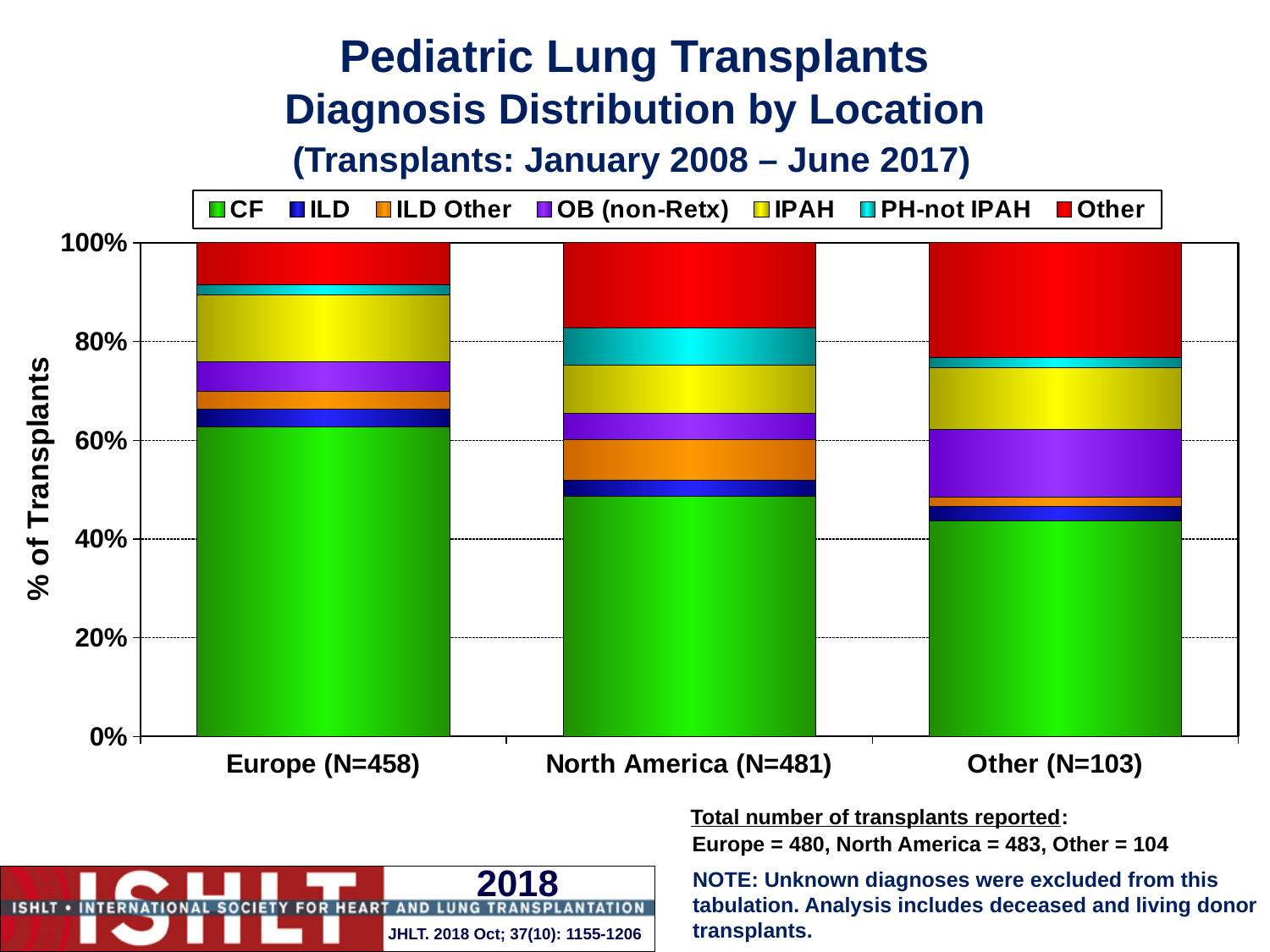
Is the CF share for Other (N=103) greater or less than 40%? greater Which location has the largest 'Other' diagnosis share? Other (N=103) How many diagnosis series does the legend list? 7 Is the CF share for Europe (N=458) greater or less than 60%? greater Which location has the largest PH-not IPAH share? North America (N=481) What is the total height of each stacked bar? 100% Is the CF share for North America (N=481) greater or less than 60%? less What is the label on the y axis? % of Transplants Is the OB (non-Retx) share larger for Other (N=103) or for North America (N=481)? Other (N=103) How many location categories are shown on the x axis? 3 What kind of chart is shown on the slide? Stacked bar chart Which location has the largest CF share of transplants? Europe (N=458)